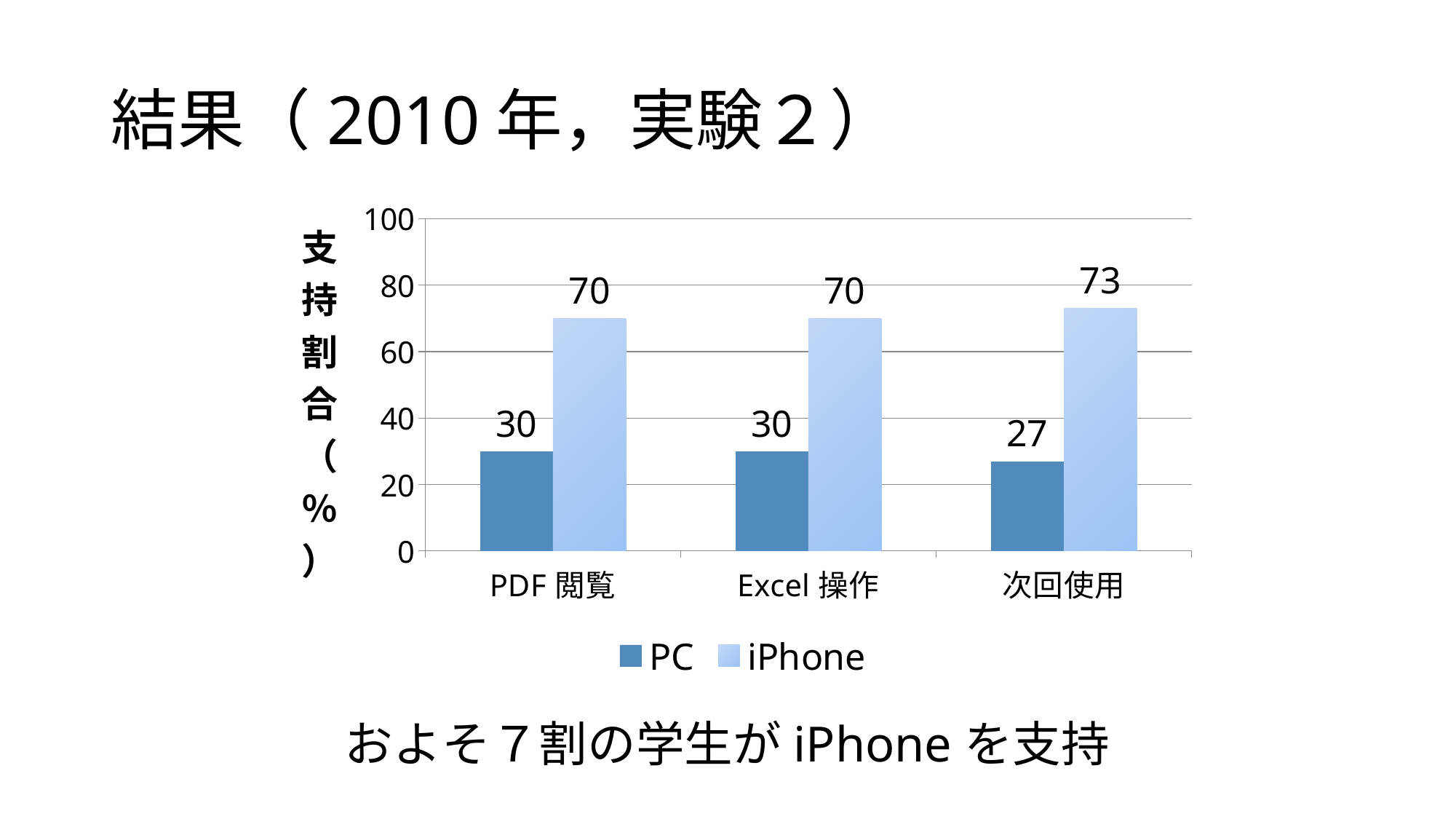
What is the value for iPhone in the 次回使用 category? 73 What is the value for iPhone in the Excel 操作 category? 70 Which category has the lowest PC value? 次回使用 How many categories are shown on the x axis? 3 Which category has the highest iPhone value? 次回使用 How many series does the legend list? 2 What is the difference between the iPhone and PC values in the PDF 閲覧 category? 40 What is the label of the vertical axis? 支持割合（%） Which is larger in the Excel 操作 category, PC or iPhone? iPhone What is the value for PC in the PDF 閲覧 category? 30 What is the difference between the iPhone and PC values in the 次回使用 category? 46 What kind of chart is shown on the slide? Bar chart